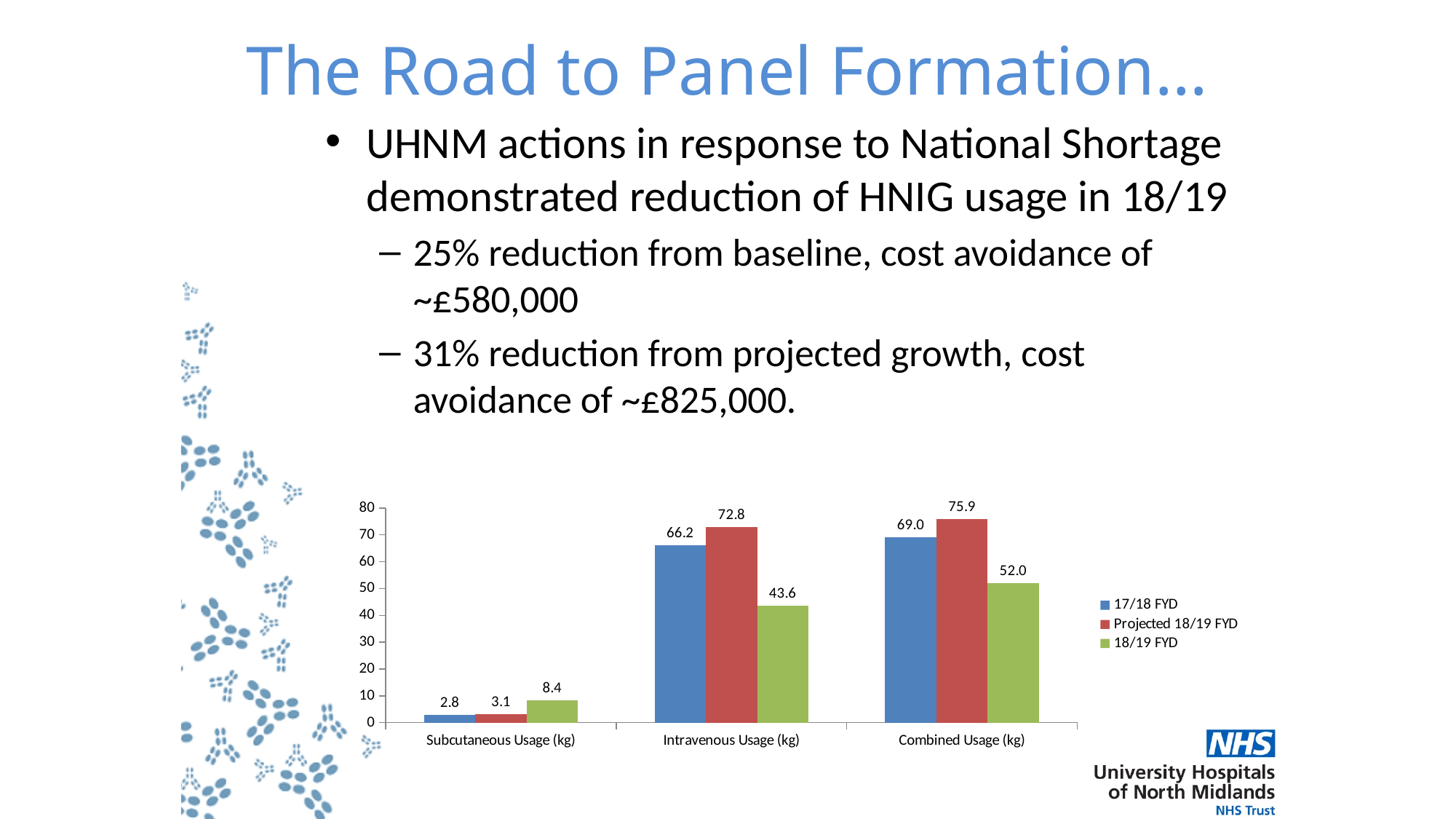
How many categories are shown on the x axis of the chart? 3 Is the 18/19 FYD value for Combined Usage (kg) greater or less than 60? less Which category has the lowest 18/19 FYD value? Subcutaneous Usage (kg) What kind of chart is shown on the slide? bar chart What is the difference between the Projected 18/19 FYD and 18/19 FYD values for Intravenous Usage (kg)? 29.2 How many series does the chart legend list? 3 What is the 18/19 FYD value for Intravenous Usage (kg)? 43.6 What is the Projected 18/19 FYD value for Combined Usage (kg)? 75.9 Which series has the highest value for Combined Usage (kg)? Projected 18/19 FYD What is the 17/18 FYD value for Subcutaneous Usage (kg)? 2.8 For Subcutaneous Usage (kg), which is larger: the 17/18 FYD value or the 18/19 FYD value? 18/19 FYD What is the difference between the 17/18 FYD and 18/19 FYD values for Combined Usage (kg)? 17.0